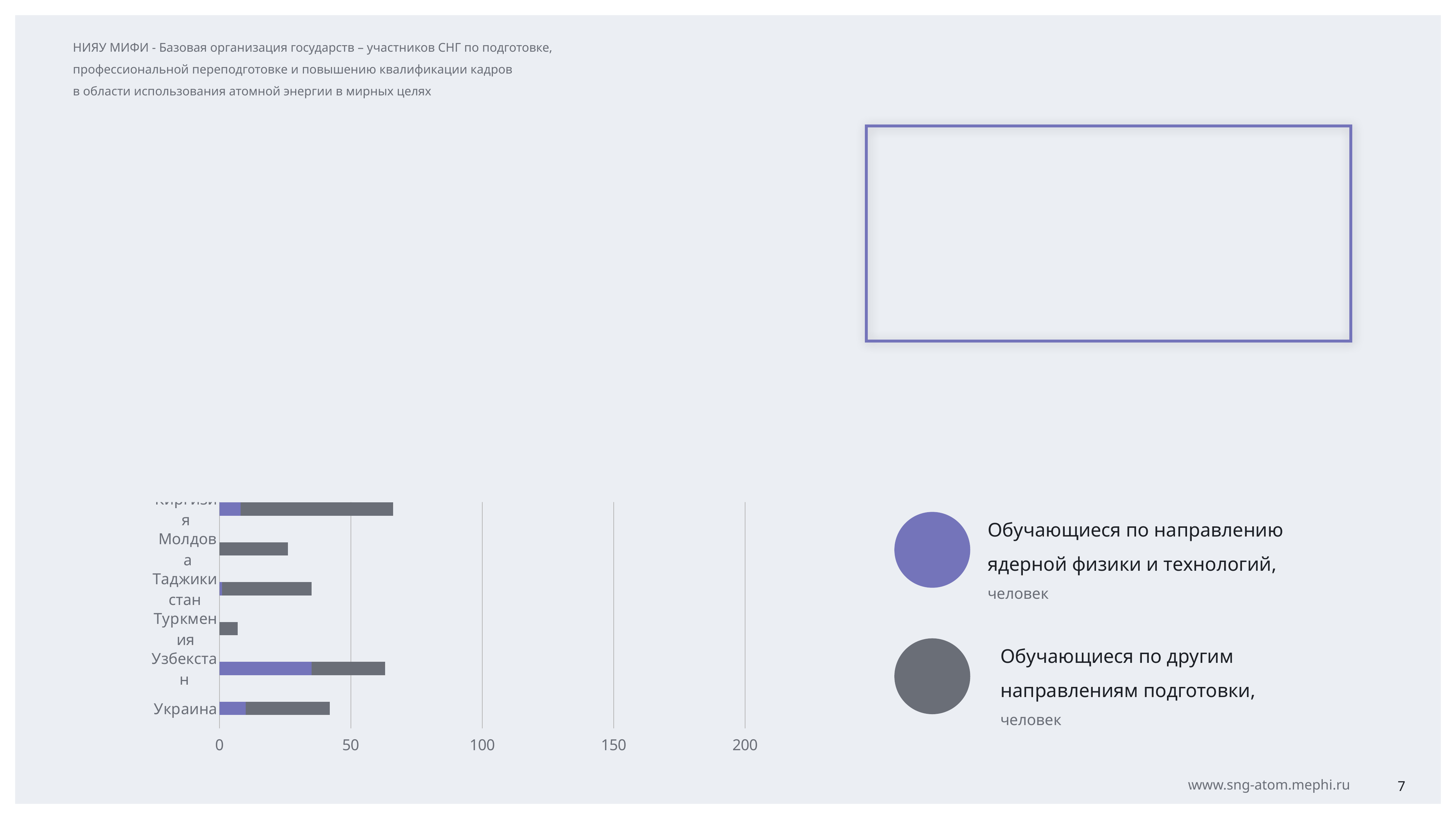
Is the total value for Узбекистан greater or less than 100? less Is the total value for Молдова greater or less than 50? less How many countries (bars) are shown in the chart? 6 Which country has the lowest total value in the chart? Туркмения Is the total value for Туркмения greater or less than 50? less How many series does the legend list? 2 What colour represents 'Обучающиеся по направлению ядерной физики и технологий' in the legend? purple Which has the larger total value, Узбекистан or Украина? Узбекистан Which has the larger total value, Молдова or Туркмения? Молдова What kind of chart is shown on the slide? bar chart